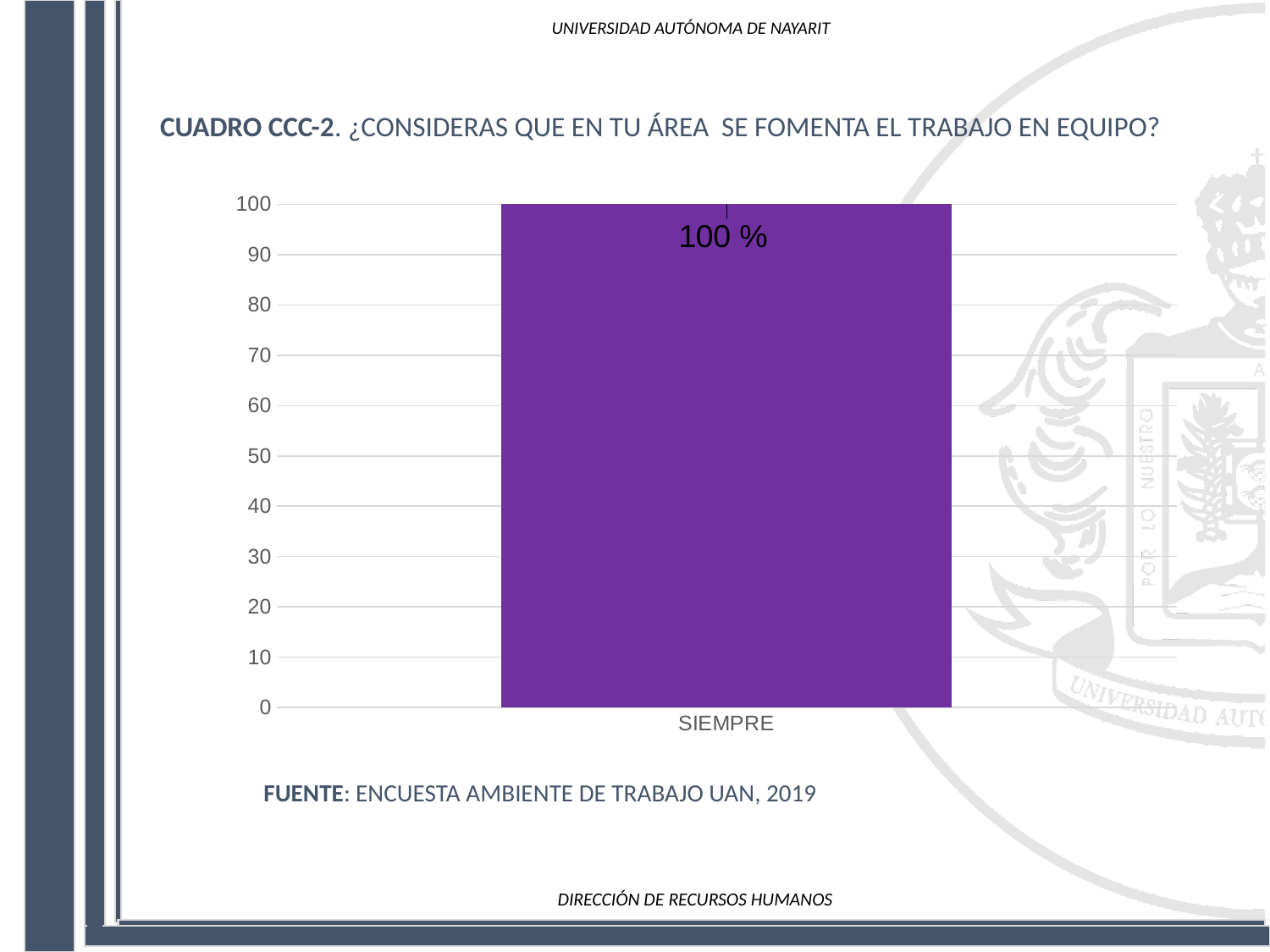
What is the maximum value shown on the y axis? 100 What colour is the bar in the chart? purple What is the label of the only category on the x axis? SIEMPRE What kind of chart is shown on the slide? bar chart Which category is the highest in the chart? SIEMPRE What is the value shown for SIEMPRE? 100 % How many categories are plotted on the x axis? 1 Is the value for SIEMPRE greater or less than 50? greater